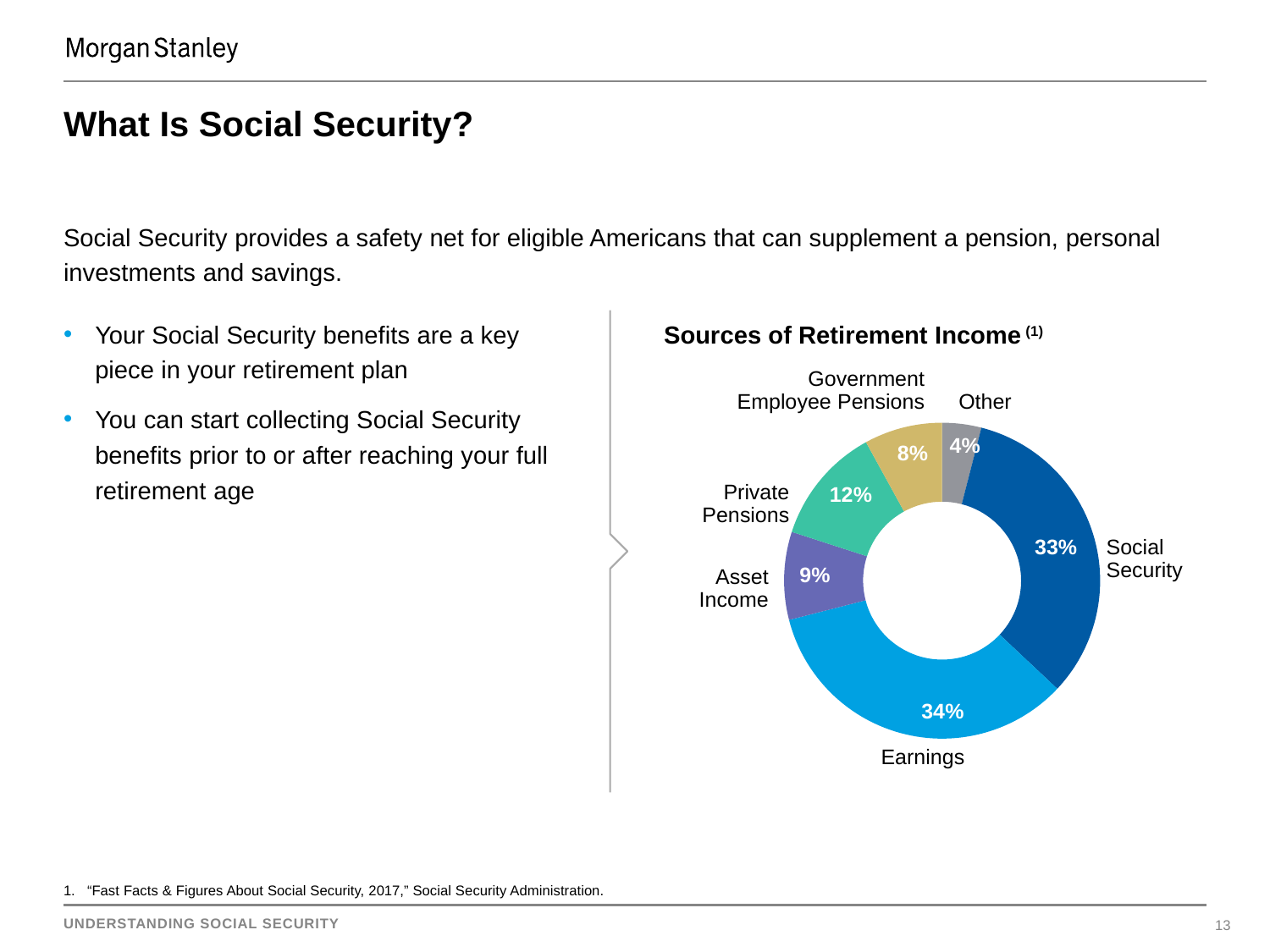
Which source of retirement income has the smallest share? Other What share of retirement income comes from Social Security? 33% What type of chart is used to show Sources of Retirement Income? Pie chart (donut) What share is attributed to Government Employee Pensions? 8% Which is larger, the share for Social Security or the share for Asset Income? Social Security How many sources of retirement income are shown in the chart? 6 What is the difference in percentage points between Private Pensions and Government Employee Pensions? 4 What percentage is shown for Private Pensions? 12% What percentage of retirement income is from Earnings? 34% Which source of retirement income has the largest share? Earnings What is the title of the chart on the slide? Sources of Retirement Income What share does Asset Income represent in the chart? 9%